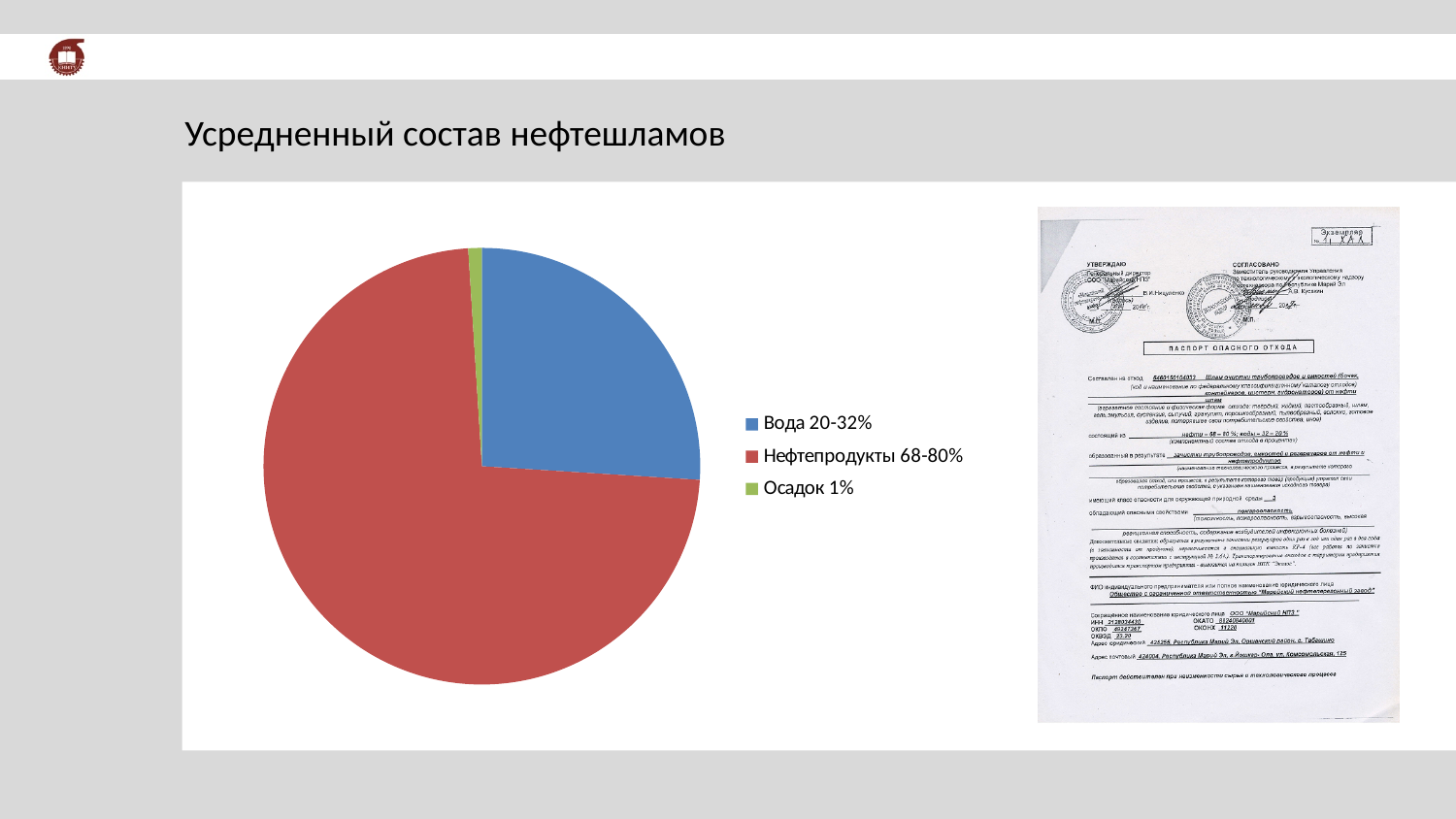
Which category takes up the smallest slice of the pie chart? Осадок What kind of chart is shown on the slide? pie chart What colour is the Нефтепродукты slice in the pie chart? red Which category takes up the largest slice of the pie chart? Нефтепродукты According to the legend, what range is given for Нефтепродукты? 68-80% Which slice is larger in the pie chart, Вода or Осадок? Вода According to the legend, what share of the pie is Осадок? 1% How many entries does the legend of the pie chart list? 3 What is the title of the slide containing the pie chart? Усредненный состав нефтешламов According to the legend, what range is given for Вода? 20-32% How many slices does the pie chart have? 3 Which slice is larger in the pie chart, Вода or Нефтепродукты? Нефтепродукты